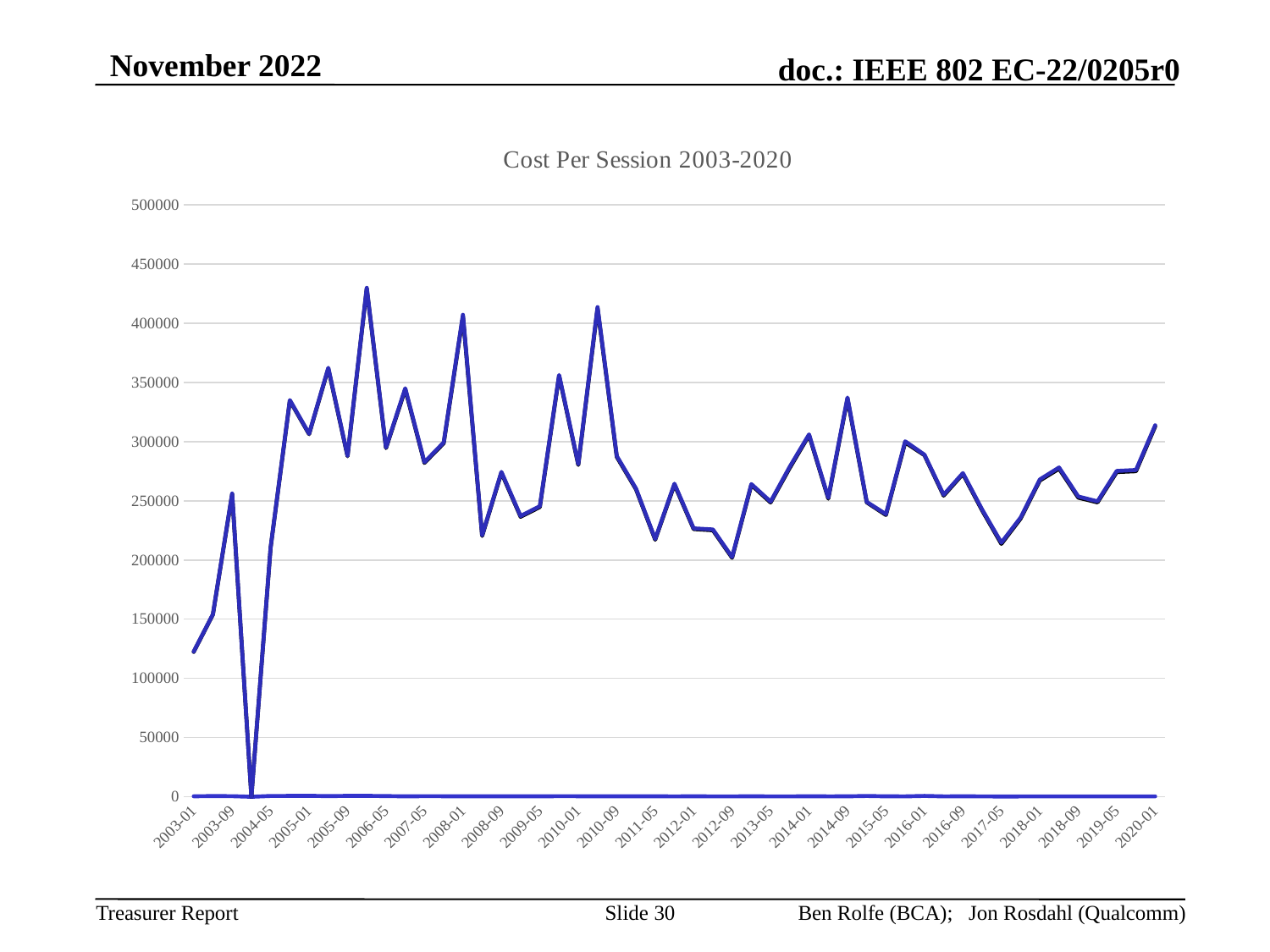
Is the value for 2020-01 greater or less than 300000? greater Which is larger, the value for 2003-01 or the value for 2020-01? 2020-01 Is the value for 2003-01 greater or less than 150000? less What is the lowest value the line reaches? 0 Is the highest point on the line greater or less than 400000? greater What is the highest value shown on the y axis? 500000 Does the line rise or fall between 2003-01 and 2003-09? rise What kind of chart is shown on the slide? line chart What is the first label on the x axis? 2003-01 What is the title of the chart? Cost Per Session 2003-2020 How many labels are shown on the x axis? 26